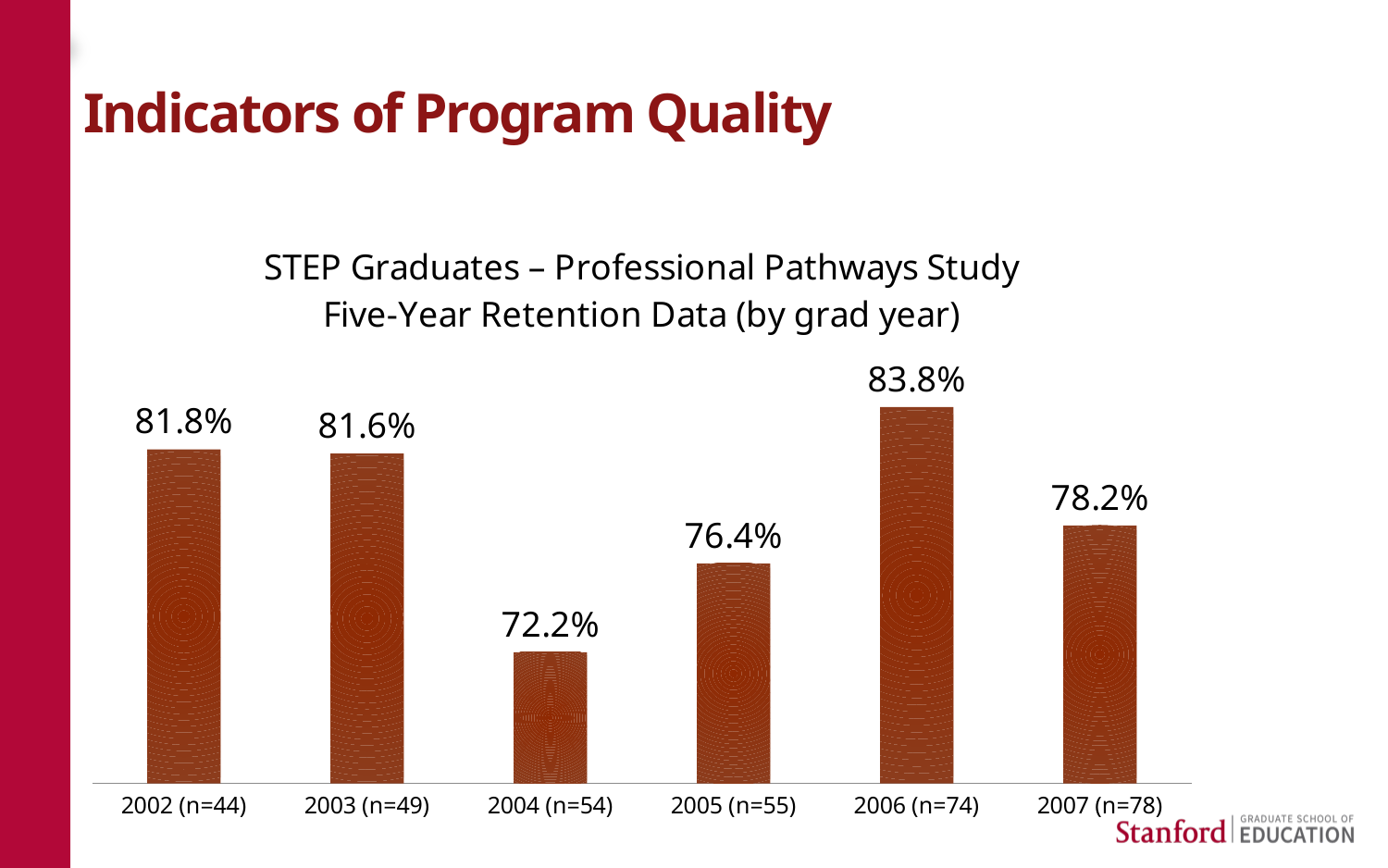
What is the difference in retention rate between the 2002 (n=44) and 2003 (n=49) cohorts? 0.2% Which graduating year has the lowest five-year retention rate? 2004 (n=54) What is the difference in retention rate between the 2006 (n=74) and 2004 (n=54) cohorts? 11.6% What is the five-year retention rate for the 2007 (n=78) graduating cohort? 78.2% What type of chart is used to show the five-year retention data? Bar chart Which cohort has a higher retention rate, 2005 (n=55) or 2007 (n=78)? 2007 (n=78) What is the five-year retention rate for the 2004 (n=54) graduating cohort? 72.2% What is the title of the chart? STEP Graduates – Professional Pathways Study Five-Year Retention Data (by grad year) Which graduating year has the highest five-year retention rate? 2006 (n=74) How many graduating year cohorts are shown in the chart? 6 Does the retention rate rise or fall from the 2003 (n=49) cohort to the 2004 (n=54) cohort? Fall What is the five-year retention rate for the 2006 (n=74) graduating cohort? 83.8%